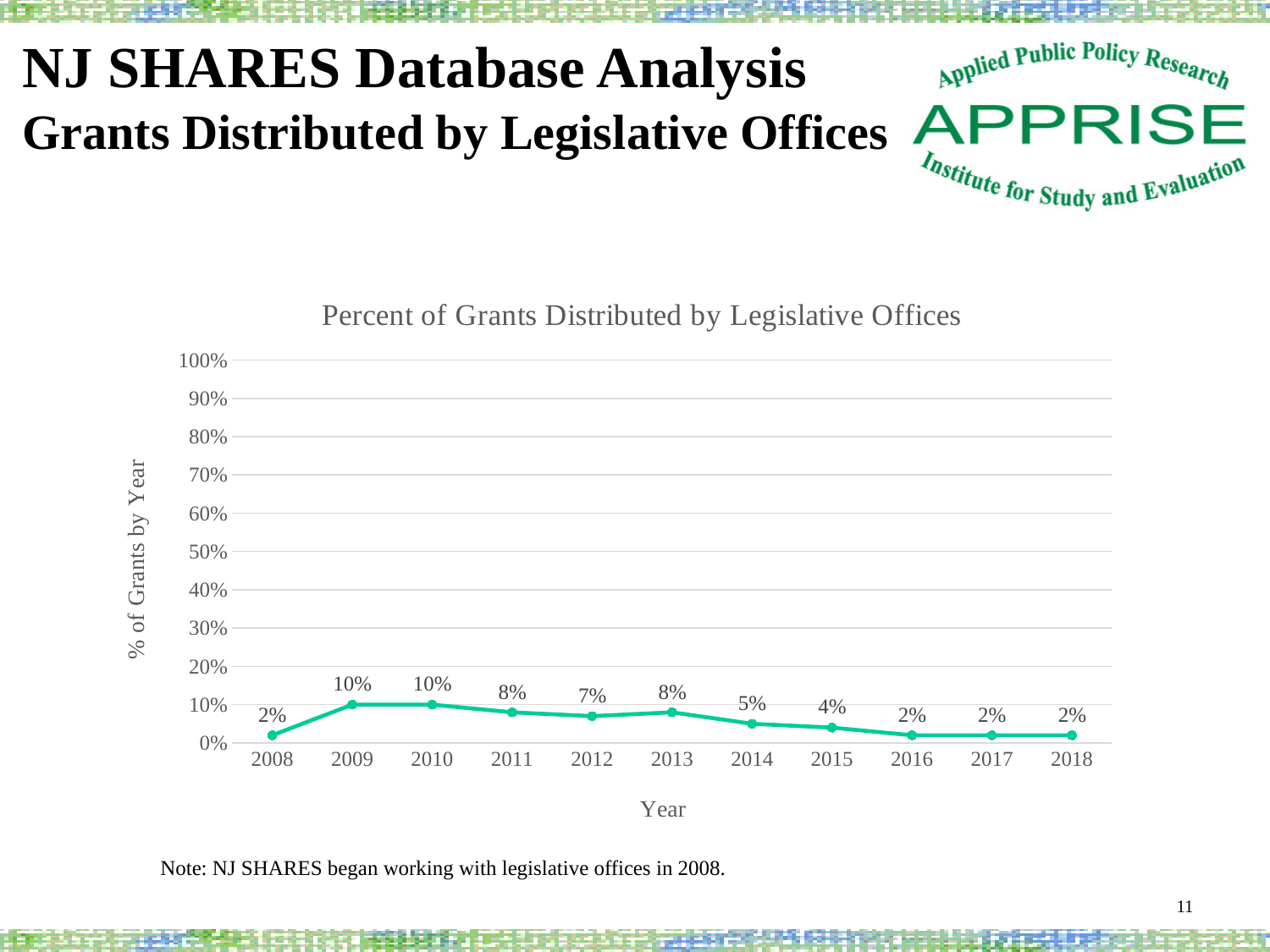
What kind of chart is shown on the slide? Line chart Do the values rise or fall from 2013 to 2016? Fall What is the title of the chart? Percent of Grants Distributed by Legislative Offices What is the value for 2008? 2% What is the difference between the value for 2010 and the value for 2018? 8% How many years are plotted on the chart? 11 What is the value for 2014? 5% What percent of grants was distributed by legislative offices in 2011? 8% Which years have the highest percent of grants distributed by legislative offices? 2009 and 2010 Which is larger, the value for 2012 or the value for 2014? 2012 Is the value for 2009 greater or less than 20%? less What is the difference between the value for 2013 and the value for 2015? 4%